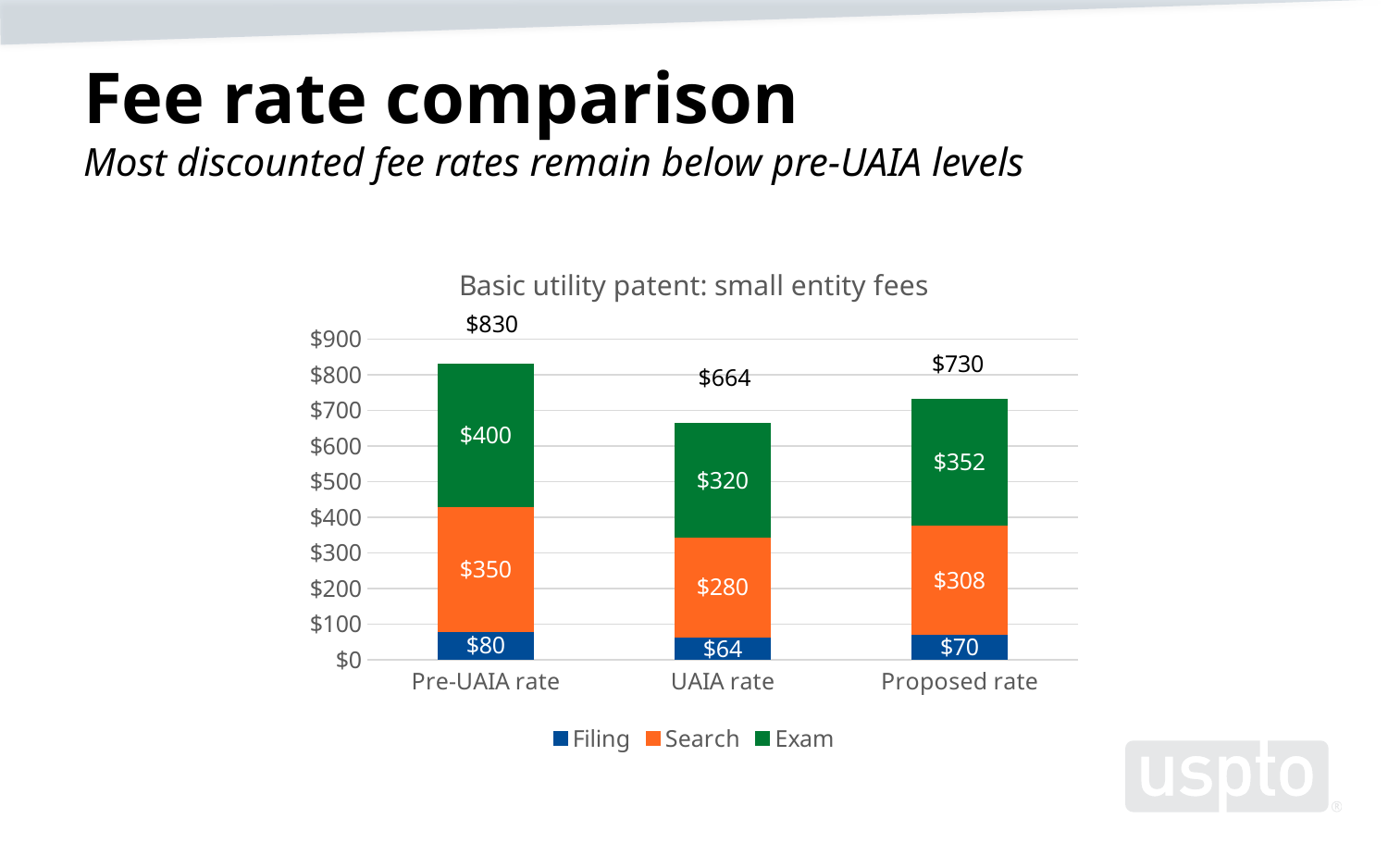
Which rate category has the lowest total fee? UAIA rate Which rate category has the highest total fee? Pre-UAIA rate Is the Exam fee larger for the Proposed rate or the UAIA rate? Proposed rate How many series does the legend list? 3 What is the total fee shown for the UAIA rate bar? $664 What kind of chart is shown on the slide? Stacked bar chart What is the Exam fee for the Pre-UAIA rate? $400 What is the Filing fee for the Proposed rate? $70 How many rate categories are shown on the x axis? 3 What is the title of the chart? Basic utility patent: small entity fees What is the Search fee for the UAIA rate? $280 What is the difference between the Pre-UAIA rate total and the Proposed rate total? $100